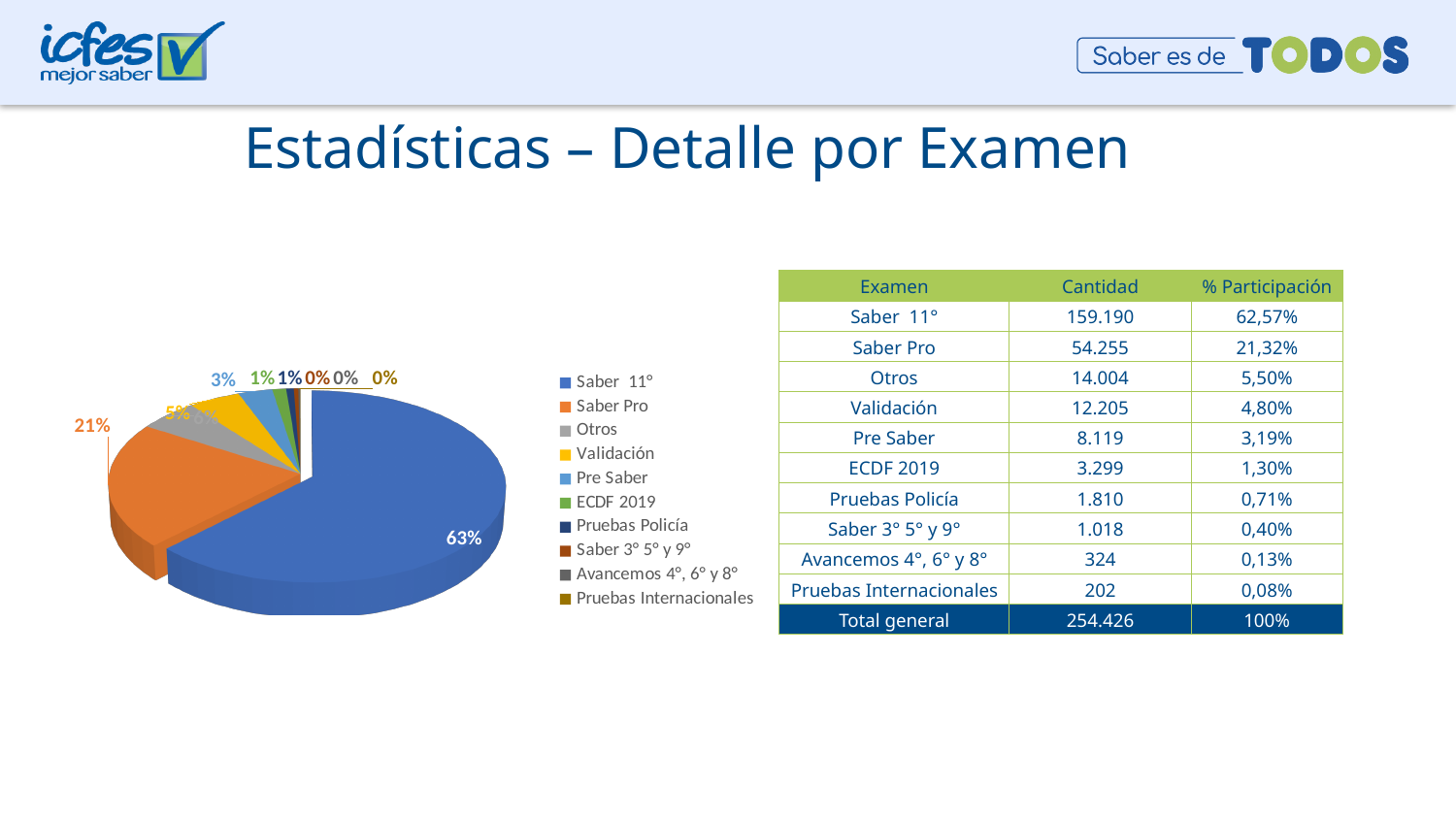
What colour is the Saber Pro slice in the pie chart? orange How many entries does the pie chart's legend list? 10 What kind of chart is shown on the slide? pie chart How many slices does the pie chart have? 10 What is the difference in percentage points between the Saber 11° slice and the Saber Pro slice in the pie chart? 42% In the pie chart, which is larger, the slice for Saber Pro or the slice for Pre Saber? Saber Pro What percentage does the pie chart show for Saber Pro? 21% What percentage does the pie chart show for Saber 11°? 63% Which legend entry is listed first in the pie chart's legend? Saber 11° What percentage does the pie chart show for Pre Saber? 3% Which category has the largest slice in the pie chart? Saber 11° What share of the pie does the Saber 11° slice represent? 63%